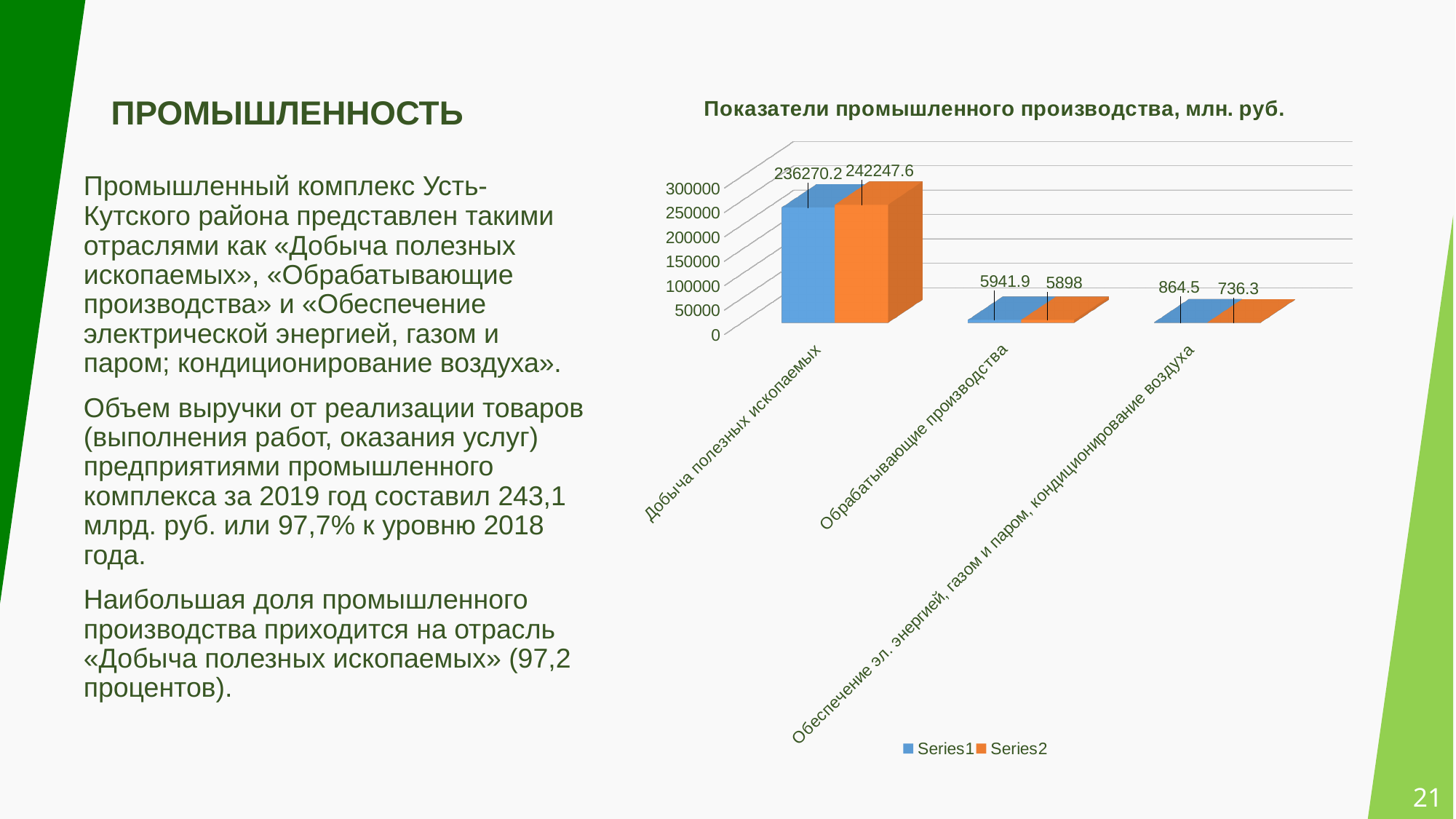
How many categories are shown on the x axis of the chart? 3 What is the Series2 value for «Добыча полезных ископаемых»? 242247.6 Which category has the lowest Series2 value? Обеспечение эл. энергией, газом и паром, кондиционирование воздуха For «Обрабатывающие производства», which is larger: the Series1 value or the Series2 value? Series1 How many series does the chart legend list? 2 What is the Series2 value for «Обеспечение эл. энергией, газом и паром, кондиционирование воздуха»? 736.3 What is the Series1 value for «Обрабатывающие производства»? 5941.9 Which category has the highest Series1 value? Добыча полезных ископаемых What is the Series1 value for «Добыча полезных ископаемых»? 236270.2 What is the Series2 value for «Обрабатывающие производства»? 5898 What is the difference between the Series2 and Series1 values for «Добыча полезных ископаемых»? 5977.4 What is the difference between the Series1 and Series2 values for «Обеспечение эл. энергией, газом и паром, кондиционирование воздуха»? 128.2